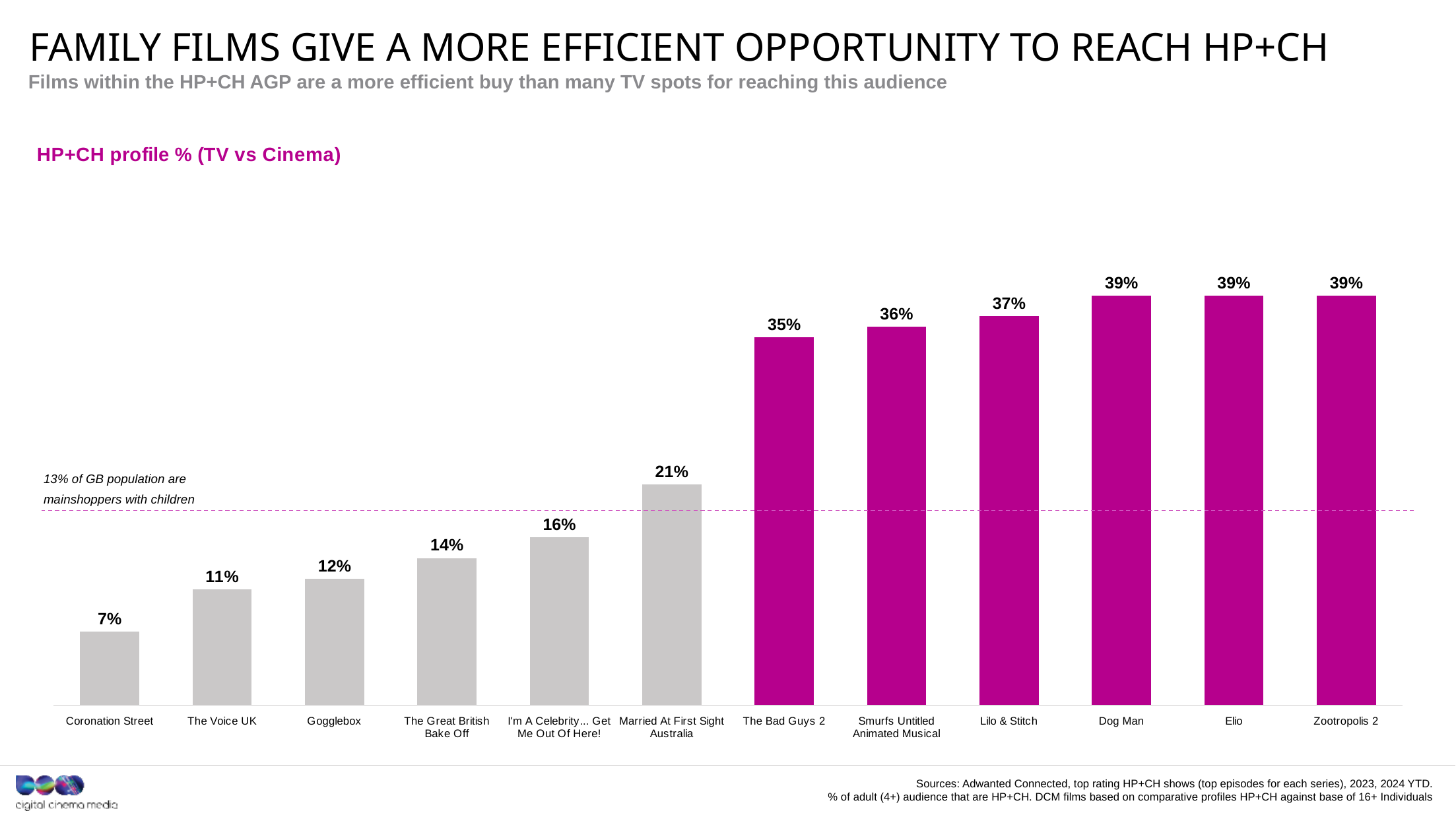
What is the HP+CH profile % for Married At First Sight Australia? 21% Which has a higher HP+CH profile %, I'm A Celebrity... Get Me Out Of Here! or Elio? Elio What is the HP+CH profile % for Lilo & Stitch? 37% What is the difference between the HP+CH profile % for Dog Man and The Bad Guys 2? 4% Which category has the lowest HP+CH profile %? Coronation Street What kind of chart is shown on the slide? Bar chart What is the HP+CH profile % for Coronation Street? 7% How many categories are shown in the chart? 12 What is the title of the chart? HP+CH profile % (TV vs Cinema) Which has a higher HP+CH profile %, The Voice UK or The Great British Bake Off? The Great British Bake Off What is the HP+CH profile % for Smurfs Untitled Animated Musical? 36% What is the difference between the HP+CH profile % for Married At First Sight Australia and Gogglebox? 9%